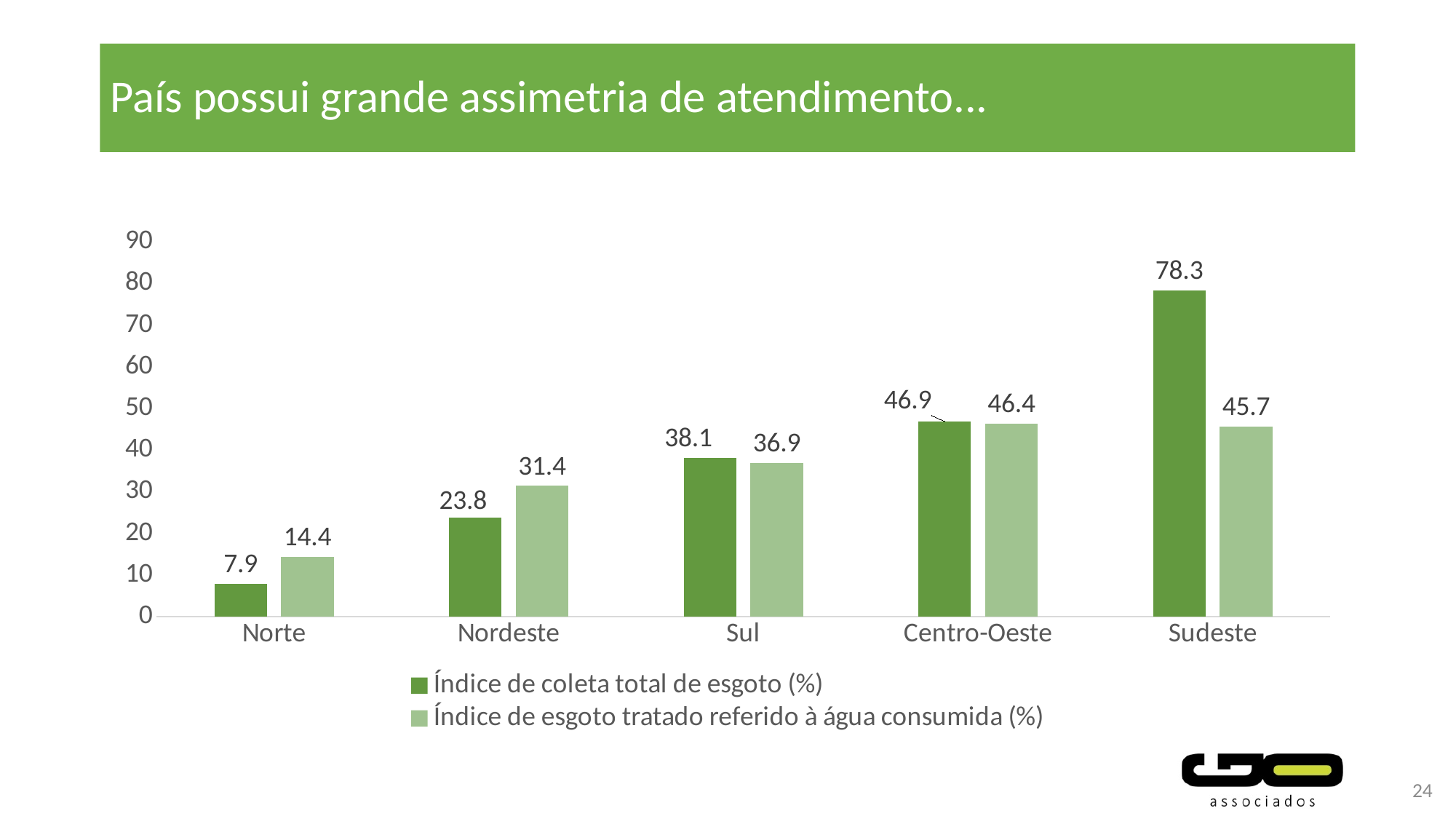
What is the value of 'Índice de coleta total de esgoto (%)' for Nordeste? 23.8 Which is larger for Nordeste: 'Índice de coleta total de esgoto (%)' or 'Índice de esgoto tratado referido à água consumida (%)'? Índice de esgoto tratado referido à água consumida (%) What kind of chart is shown on the slide? Bar chart Does 'Índice de coleta total de esgoto (%)' rise or fall from Norte to Sudeste along the x axis? Rise Which region has the highest 'Índice de coleta total de esgoto (%)'? Sudeste What is the title of the slide? País possui grande assimetria de atendimento... Which region has the lowest 'Índice de esgoto tratado referido à água consumida (%)'? Norte What is the value of 'Índice de esgoto tratado referido à água consumida (%)' for Norte? 14.4 What is the value of 'Índice de coleta total de esgoto (%)' for Sudeste? 78.3 What is the difference between the two series for Sudeste? 32.6 How many series does the legend list? 2 How many regions are shown on the x axis? 5